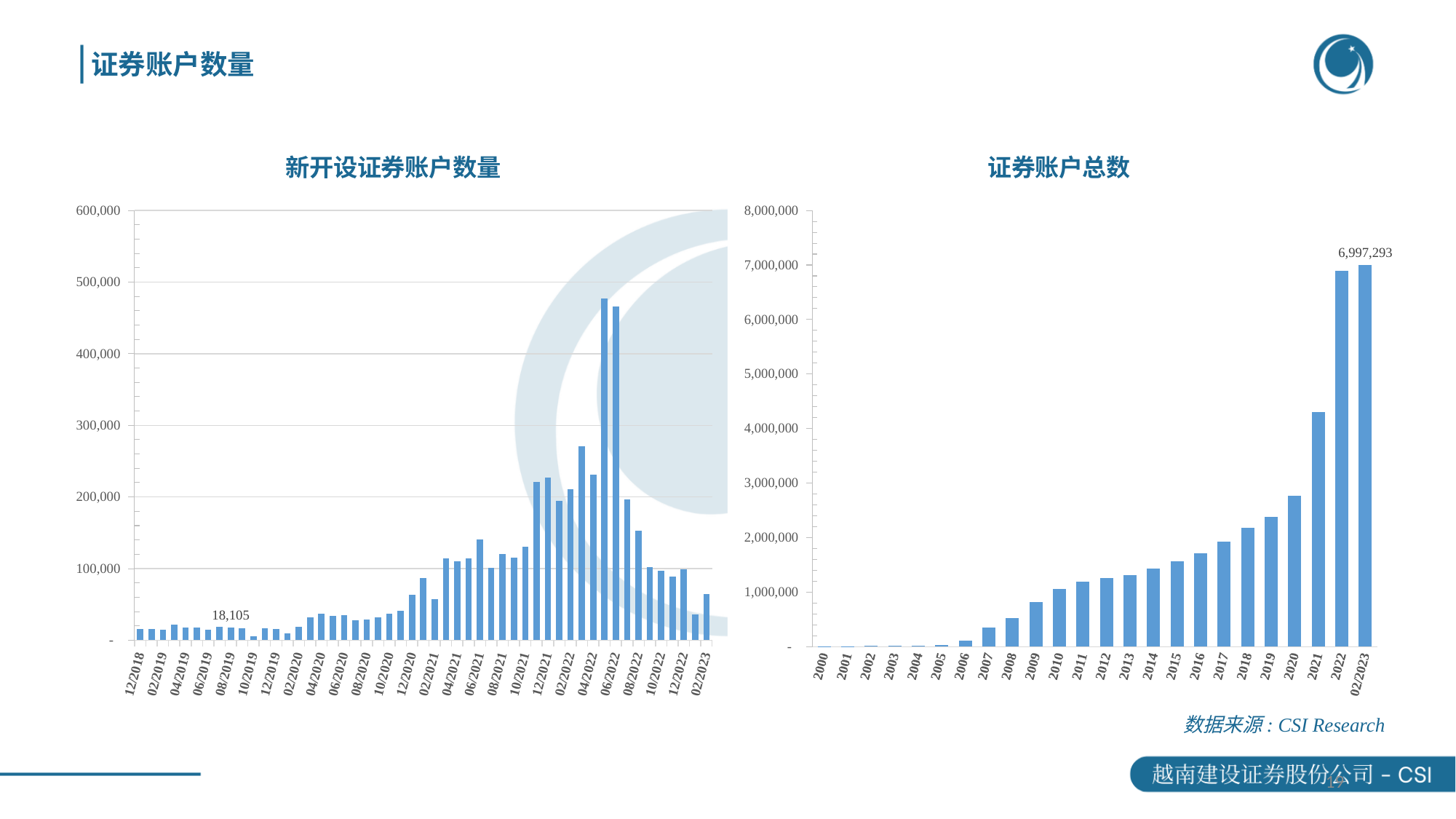
In the right chart (证券账户总数), is the value for 2020 greater or less than 3,000,000? less In the left chart (新开设证券账户数量), is the value for 12/2018 greater or less than 100,000? less In the left chart (新开设证券账户数量), is the value for 06/2022 greater or less than 400,000? greater In the right chart (证券账户总数), which category has the highest value? 02/2023 How many categories are shown on the x axis of the right chart (证券账户总数)? 24 In the right chart (证券账户总数), do the values generally rise or fall from 2000 to 02/2023? rise What type of chart is the right chart titled 证券账户总数? bar chart In the right chart (证券账户总数), which category has the lowest value? 2000 In the right chart (证券账户总数), what is the value for 02/2023? 6,997,293 In the right chart (证券账户总数), which is larger, the value for 2021 or the value for 2022? 2022